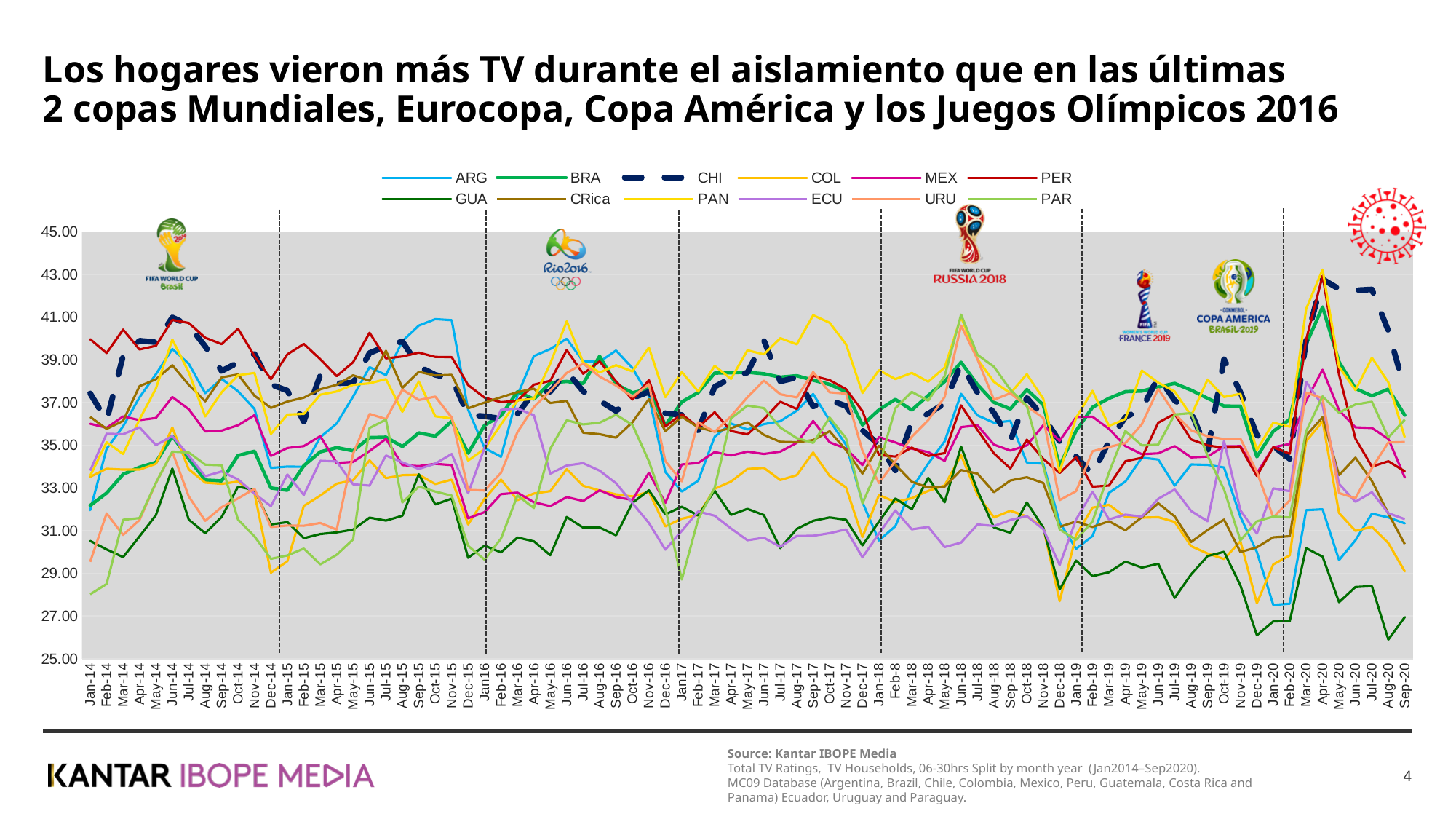
Which series has the lowest value in Jan-14? PAR Is the value for CHI in Apr-20 greater or less than 41? greater Is the value for GUA in Aug-20 greater or less than 27? less Which series has the lowest value in Sep-20? GUA What is the highest value shown on the y axis? 45.00 How many series does the legend list? 12 What kind of chart is shown on the slide? Line chart Is the value for ARG in Dec-19 greater or less than 29? greater Does the ARG line rise or fall from Jan-20 to Apr-20? rise Which series in the legend is drawn as a dashed line? CHI